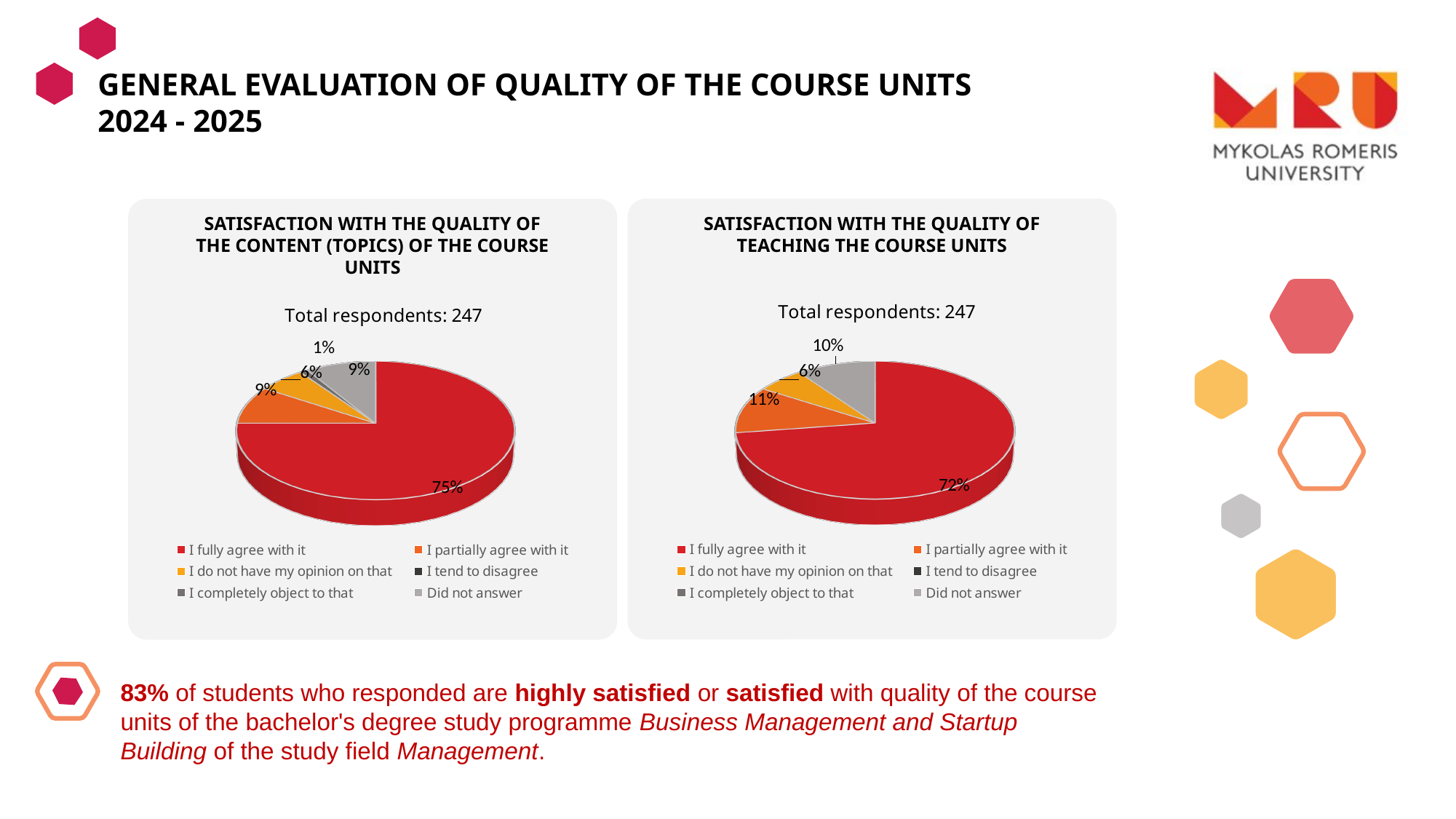
What is the difference between the 'I fully agree with it' shares in the left chart (content) and the right chart (teaching)? 3% What type of chart is used for 'Satisfaction with the quality of teaching the course units'? Pie chart In the chart 'Satisfaction with the quality of the content (topics) of the course units', what share of respondents chose 'I partially agree with it'? 9% In the chart 'Satisfaction with the quality of the content (topics) of the course units', what share of respondents chose 'I do not have my opinion on that'? 6% In the chart 'Satisfaction with the quality of teaching the course units', what share of respondents 'Did not answer'? 10% In the chart 'Satisfaction with the quality of teaching the course units', what share of respondents chose 'I partially agree with it'? 11% In the chart 'Satisfaction with the quality of teaching the course units', what share of respondents chose 'I fully agree with it'? 72% Which category has the largest slice in the chart 'Satisfaction with the quality of teaching the course units'? I fully agree with it How many entries does the legend of the chart 'Satisfaction with the quality of the content (topics) of the course units' list? 6 Which chart has the larger 'I partially agree with it' share: the content chart or the teaching chart? The teaching chart How many total respondents are reported for the chart 'Satisfaction with the quality of teaching the course units'? 247 In the chart 'Satisfaction with the quality of the content (topics) of the course units', what share of respondents chose 'I fully agree with it'? 75%